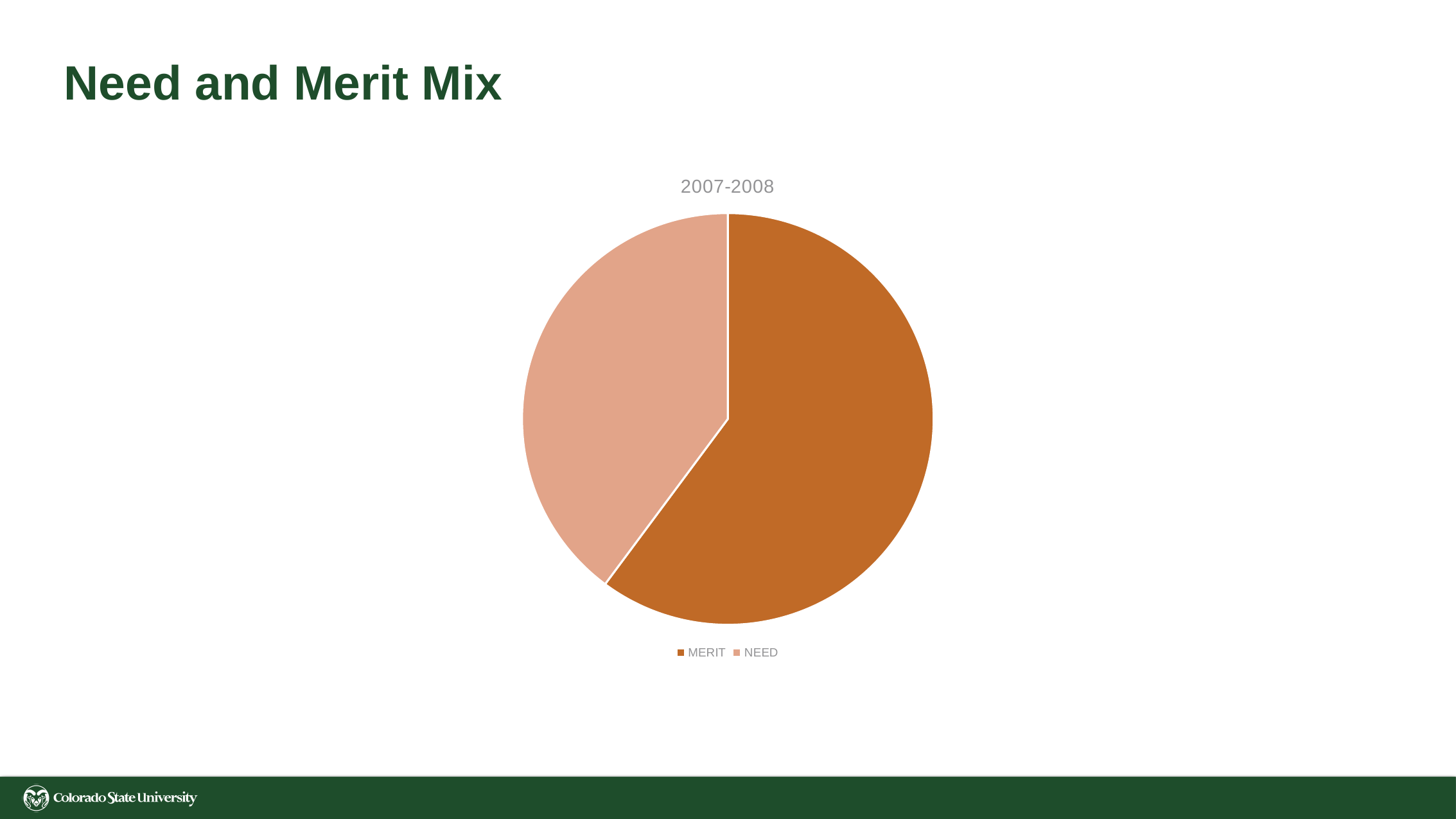
What is the title of the chart? 2007-2008 How many entries does the legend list? 2 Does the MERIT slice take up more or less than half of the pie? More What kind of chart is shown on the slide? Pie chart Which category has the smallest slice of the pie? NEED What are the two categories shown in the legend? MERIT and NEED Which category has the largest slice of the pie? MERIT How many slices does the pie chart have? 2 Which slice is larger, MERIT or NEED? MERIT